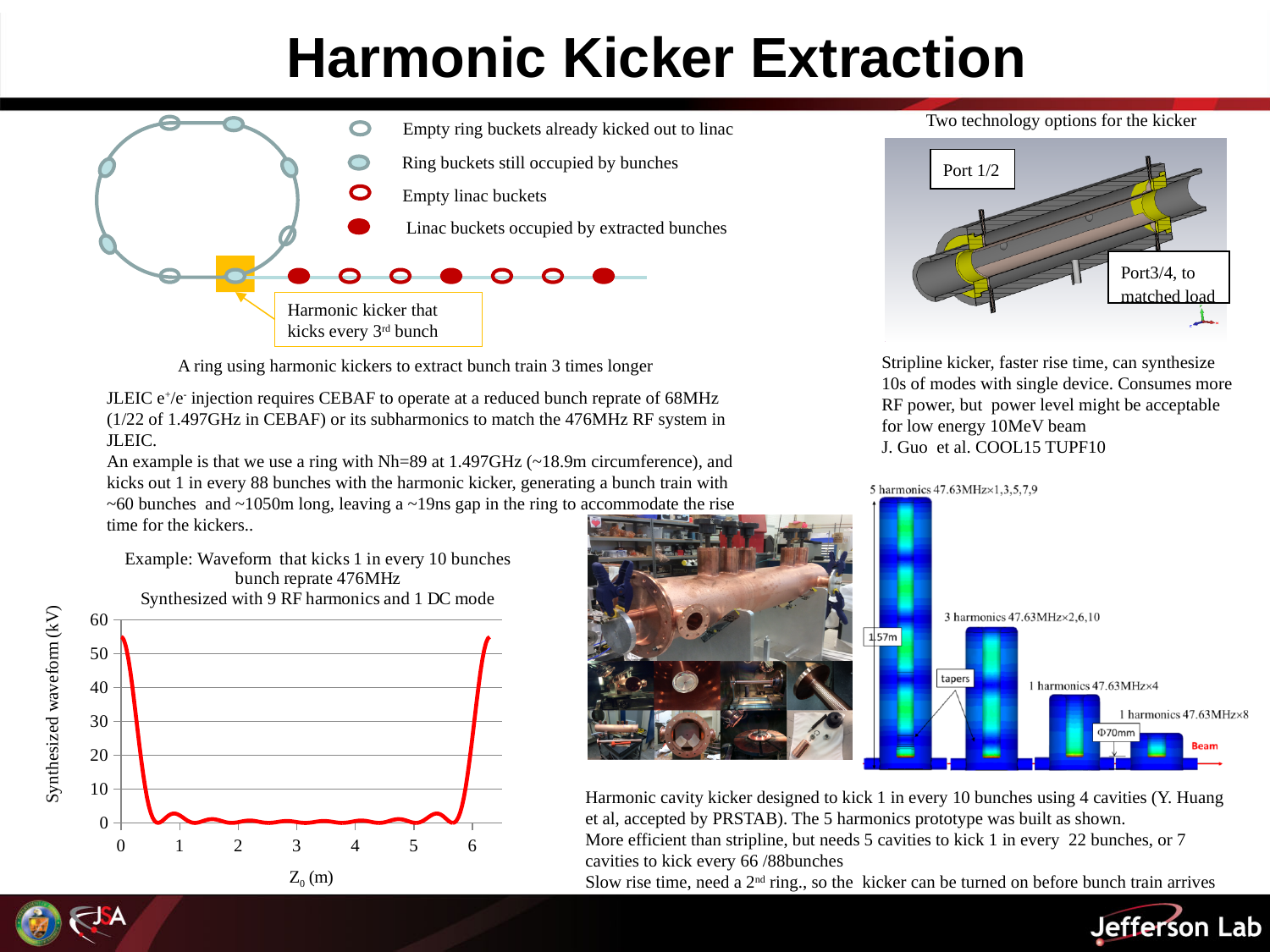
On the waveform chart, is the value at Z0 = 4 m larger or smaller than the value at Z0 = 6 m? smaller On the waveform chart, is the value at Z0 = 0 m greater or less than 50 kV? greater On the waveform chart, does the waveform rise or fall between Z0 = 0 m and Z0 = 1 m? fall On the waveform chart, is the value at Z0 = 1 m greater or less than 20 kV? less On the waveform chart, is the value at Z0 = 0 m larger or smaller than the value at Z0 = 2 m? larger On the waveform chart, does the waveform rise or fall between Z0 = 5 m and Z0 = 6 m? rise On the waveform chart, what is the label of the horizontal axis? Z0 (m) On the waveform chart, what is the label of the vertical axis? Synthesized waveform (kV) What kind of chart is the 'Synthesized waveform' chart on the lower left of the slide? line chart On the waveform chart, is the value at Z0 = 3 m greater or less than 10 kV? less